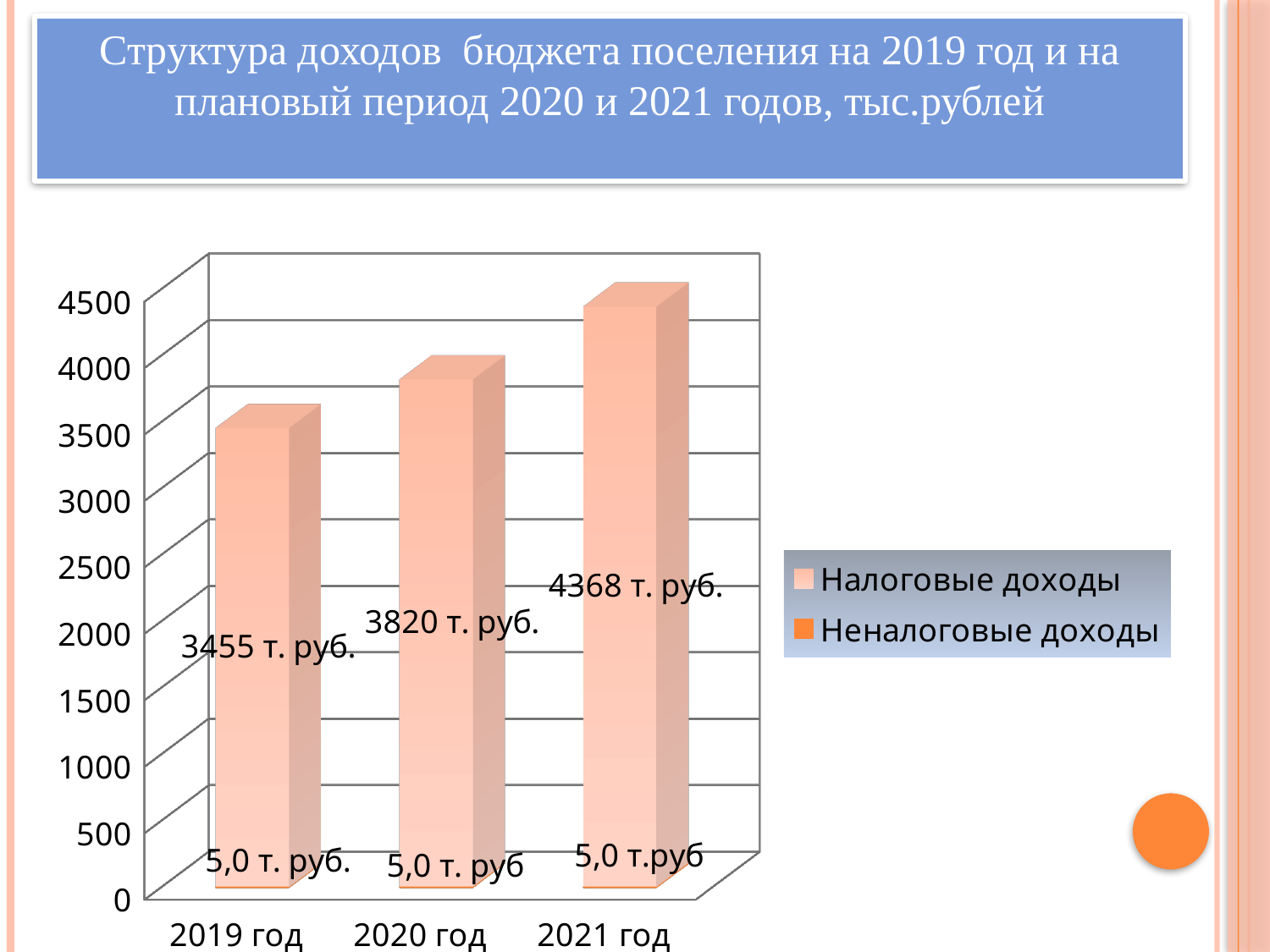
What is the value of Налоговые доходы for 2020 год? 3820 т. руб. What is the value of Неналоговые доходы for 2019 год? 5,0 т. руб. What is the value of Налоговые доходы for 2019 год? 3455 т. руб. How many series does the legend list? 2 How many years are shown on the x axis? 3 Which year has the lowest Налоговые доходы? 2019 год Which is larger, Налоговые доходы for 2020 год or for 2019 год? 2020 год Do the Налоговые доходы values rise or fall from 2019 год to 2021 год? Rise What kind of chart is shown on the slide? Bar chart What is the value of Налоговые доходы for 2021 год? 4368 т. руб. What is the difference in Налоговые доходы between 2021 год and 2019 год? 913 т. руб. Which year has the highest Налоговые доходы? 2021 год